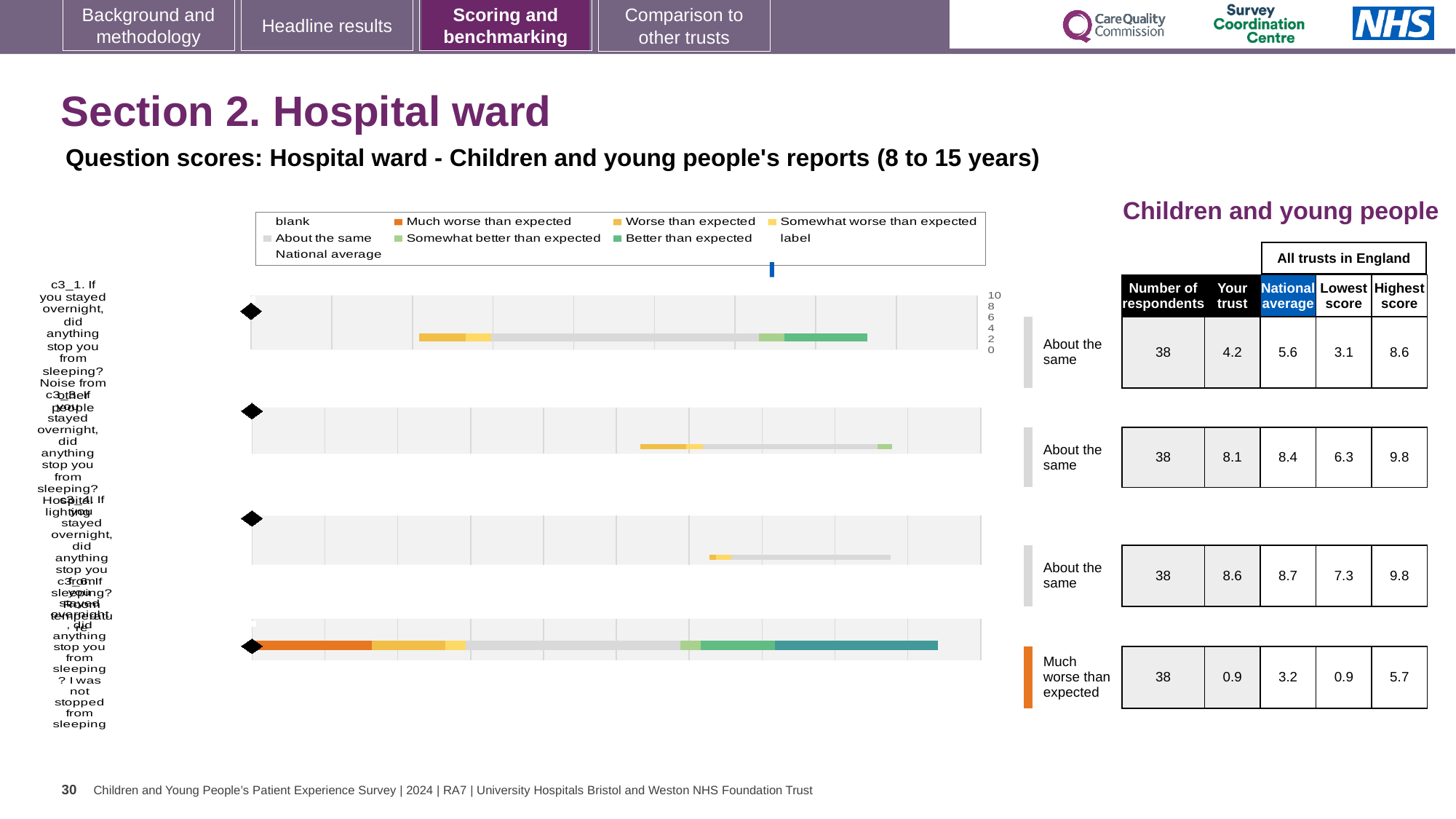
Which row has the highest 'Your trust' score in the table beside the chart? the third row (8.6) For the first row, which is larger: the 'Your trust' score or the national average? the national average (5.6) What benchmark category is given for the fourth (bottom) row of the chart? Much worse than expected For the second row, what is the difference between the highest score and the lowest score shown in the table? 3.5 What colour represents 'Much worse than expected' in the chart legend? orange Which row has the lowest 'Your trust' score in the table beside the chart? the fourth row (0.9) What kind of chart is shown on the slide? bar chart In the table beside the chart, what is the 'Your trust' score for the first (top) row? 4.2 How many respondents are listed for each row in the table beside the chart? 38 In the table beside the chart, what is the national average for the fourth (bottom) row? 3.2 How many horizontal bars (question rows) does the chart contain? 4